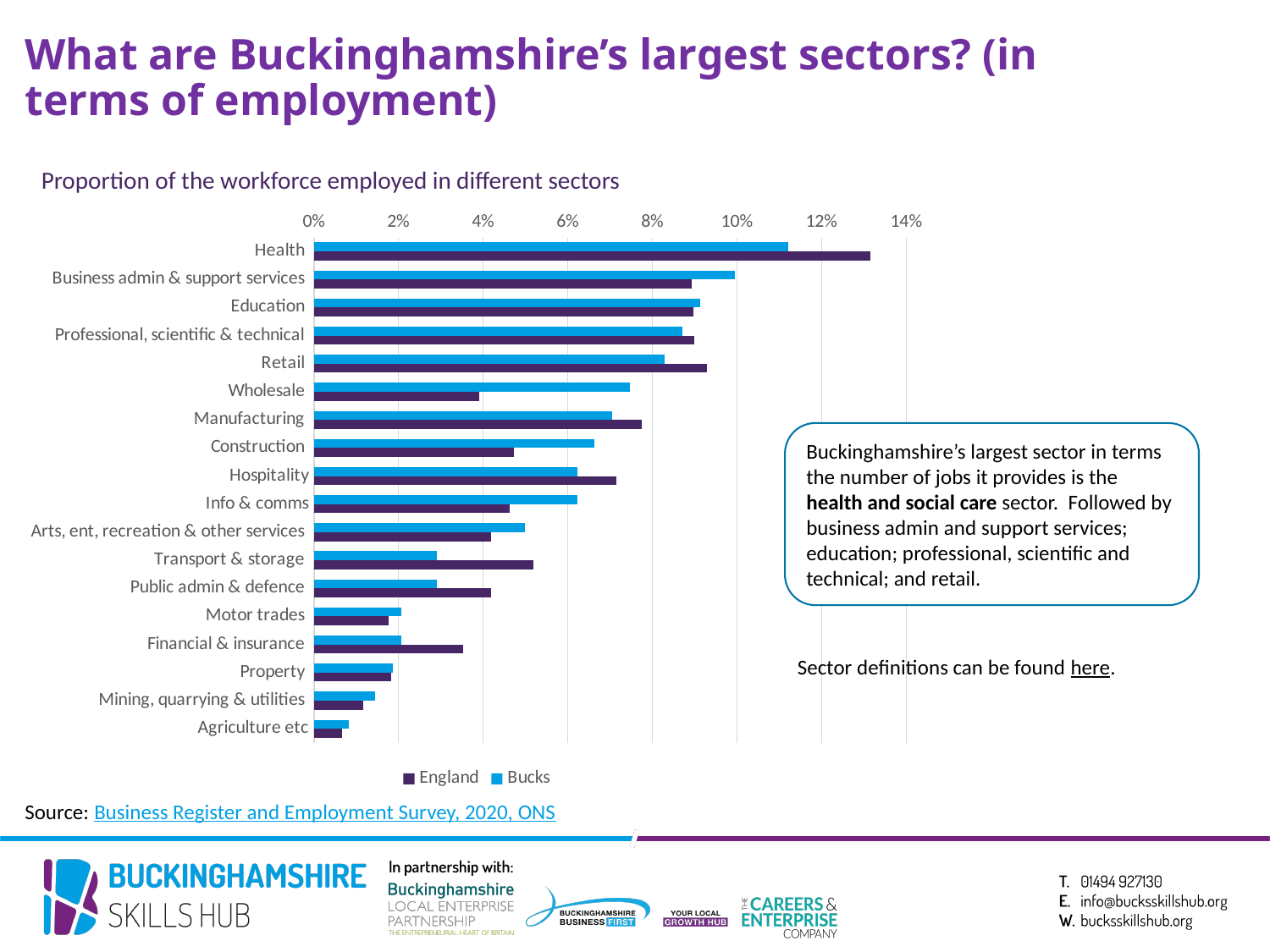
For Wholesale, which is larger: the England value or the Bucks value? Bucks How many sectors are plotted on the chart? 18 What are the two series named in the legend? England and Bucks Which sector has the highest Bucks value? Health How many series does the legend list? 2 Is the Bucks value for Health greater or less than 10%? greater Is the England value for Health greater or less than 12%? greater Is the Bucks value for Construction greater or less than 6%? greater What kind of chart is shown on the slide? bar chart For Transport & storage, which is larger: the England value or the Bucks value? England Which sector has the lowest Bucks value? Agriculture etc